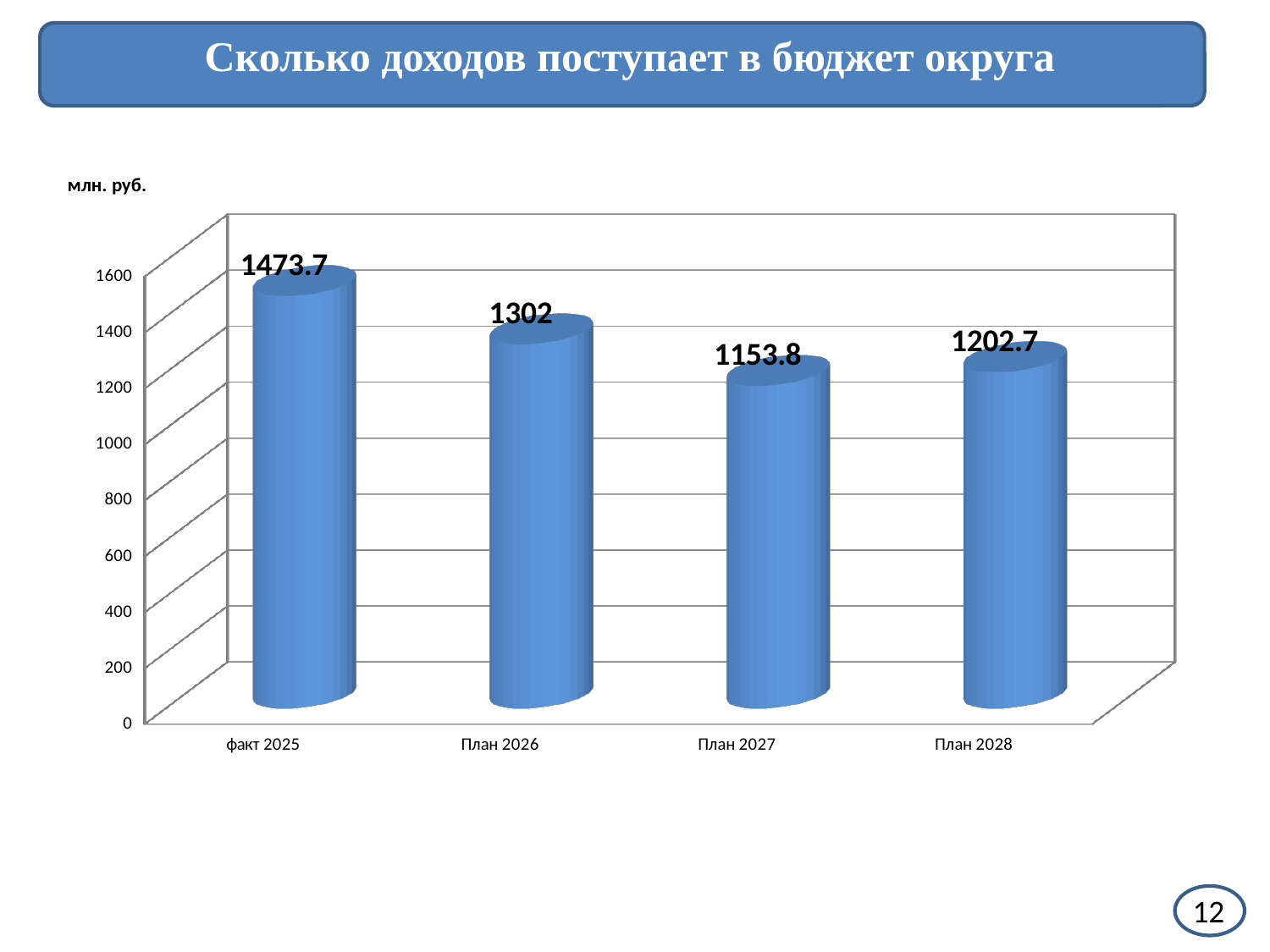
What is the value for План 2028? 1202.7 What is the difference between the values for факт 2025 and План 2026? 171.7 Which is larger, the value for План 2026 or the value for План 2028? План 2026 What is the value for План 2026? 1302 What kind of chart is shown on the slide? bar chart Which category has the highest value? факт 2025 Which category has the lowest value? План 2027 What is the value for План 2027? 1153.8 What unit is indicated above the chart's vertical axis? млн. руб. What is the value for факт 2025? 1473.7 What is the difference between the values for План 2028 and План 2027? 48.9 How many categories are shown on the chart? 4